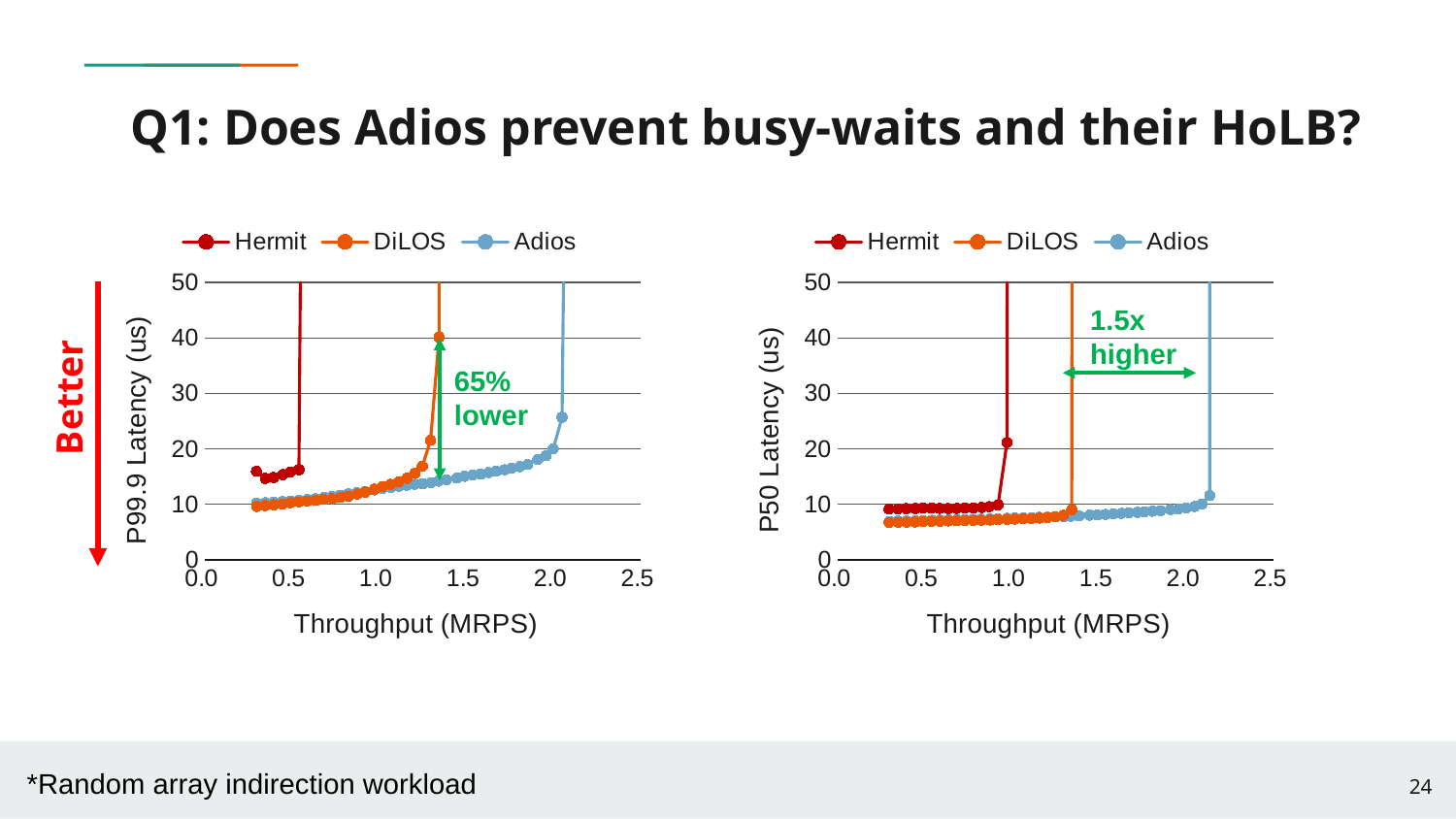
In the right chart (P50 Latency), which series has its latency spike at the lowest throughput? Hermit In the left chart (P99.9 Latency), is the throughput at which Hermit's latency spikes greater or less than 1.0 MRPS? less In the left chart (P99.9 Latency), what is the label of the x axis? Throughput (MRPS) In the right chart (P50 Latency), is the P50 latency of DiLOS at 1.0 MRPS greater or less than 10 us? less In the left chart (P99.9 Latency), what percentage improvement does the annotation claim for Adios over DiLOS? 65% lower In the right chart (P50 Latency), is the throughput at which Adios's latency spikes greater or less than 2.0 MRPS? greater In the left chart (P99.9 Latency), which series reaches the highest throughput before its latency spikes? Adios In the left chart (P99.9 Latency), does the Adios latency rise or fall as throughput increases? rise In the right chart (P50 Latency), which series has the highest P50 latency at 0.5 MRPS? Hermit In the right chart (P50 Latency), what does the annotation between the DiLOS and Adios lines say? 1.5x higher In the left chart (P99.9 Latency), how many series does the legend list? 3 In the right chart (P50 Latency), what kind of chart is shown? Line chart